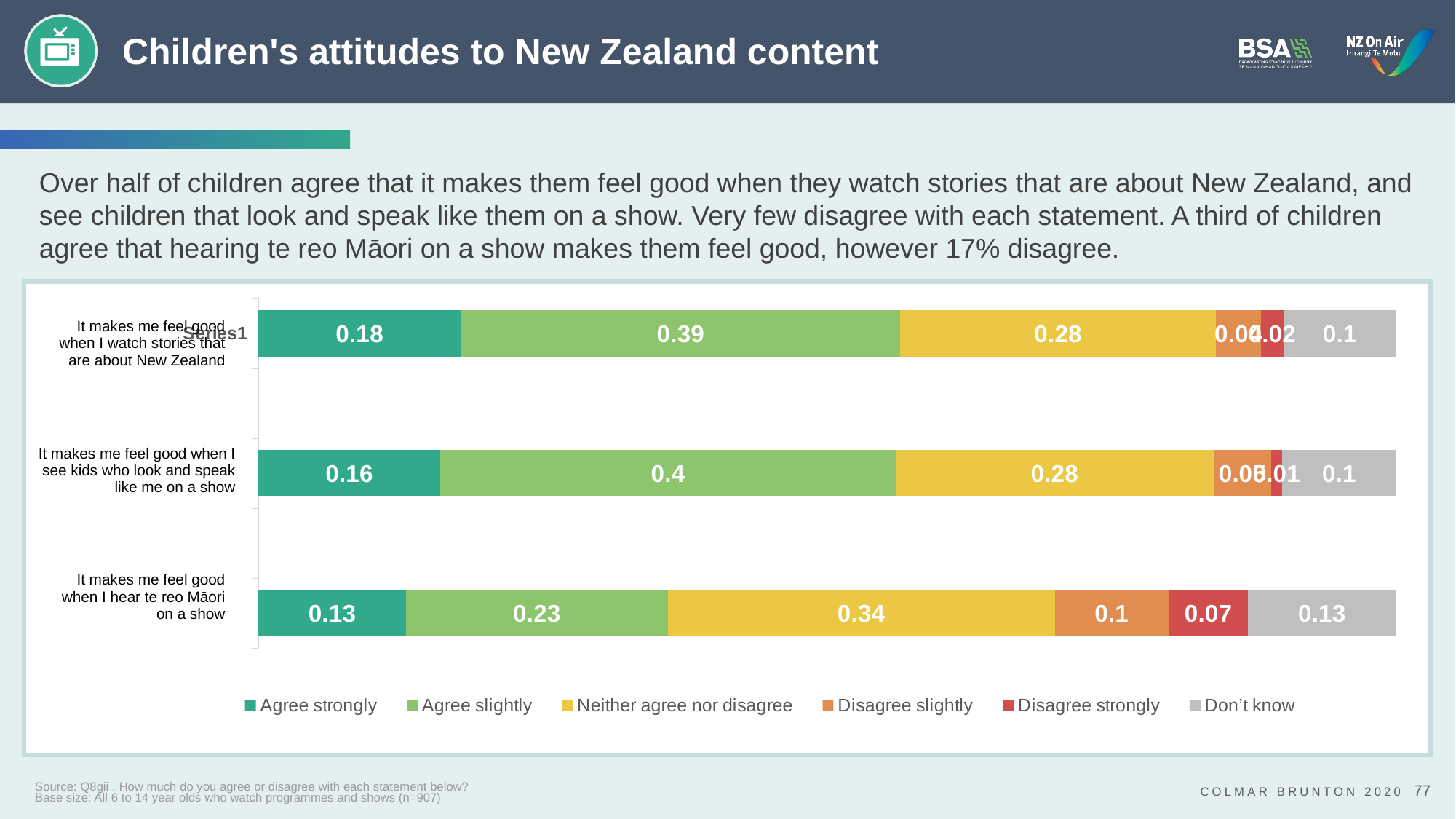
How many statements are shown in the chart? 3 What kind of chart is shown on the slide? Stacked bar chart What is the value for Agree strongly for "It makes me feel good when I watch stories that are about New Zealand"? 0.18 Which statement has the lowest Agree slightly value? It makes me feel good when I hear te reo Māori on a show Which is larger: the Disagree slightly value for the te reo Māori statement or its Disagree strongly value? Disagree slightly Which statement has the highest Agree strongly value? It makes me feel good when I watch stories that are about New Zealand What is the value for Disagree strongly for "It makes me feel good when I hear te reo Māori on a show"? 0.07 What is the value for Agree slightly for "It makes me feel good when I see kids who look and speak like me on a show"? 0.4 How many series does the legend list? 6 What is the value for Don't know for "It makes me feel good when I hear te reo Māori on a show"? 0.13 What is the difference between the Agree slightly values for the "stories that are about New Zealand" statement and the "te reo Māori" statement? 0.16 What is the value for Neither agree nor disagree for "It makes me feel good when I hear te reo Māori on a show"? 0.34